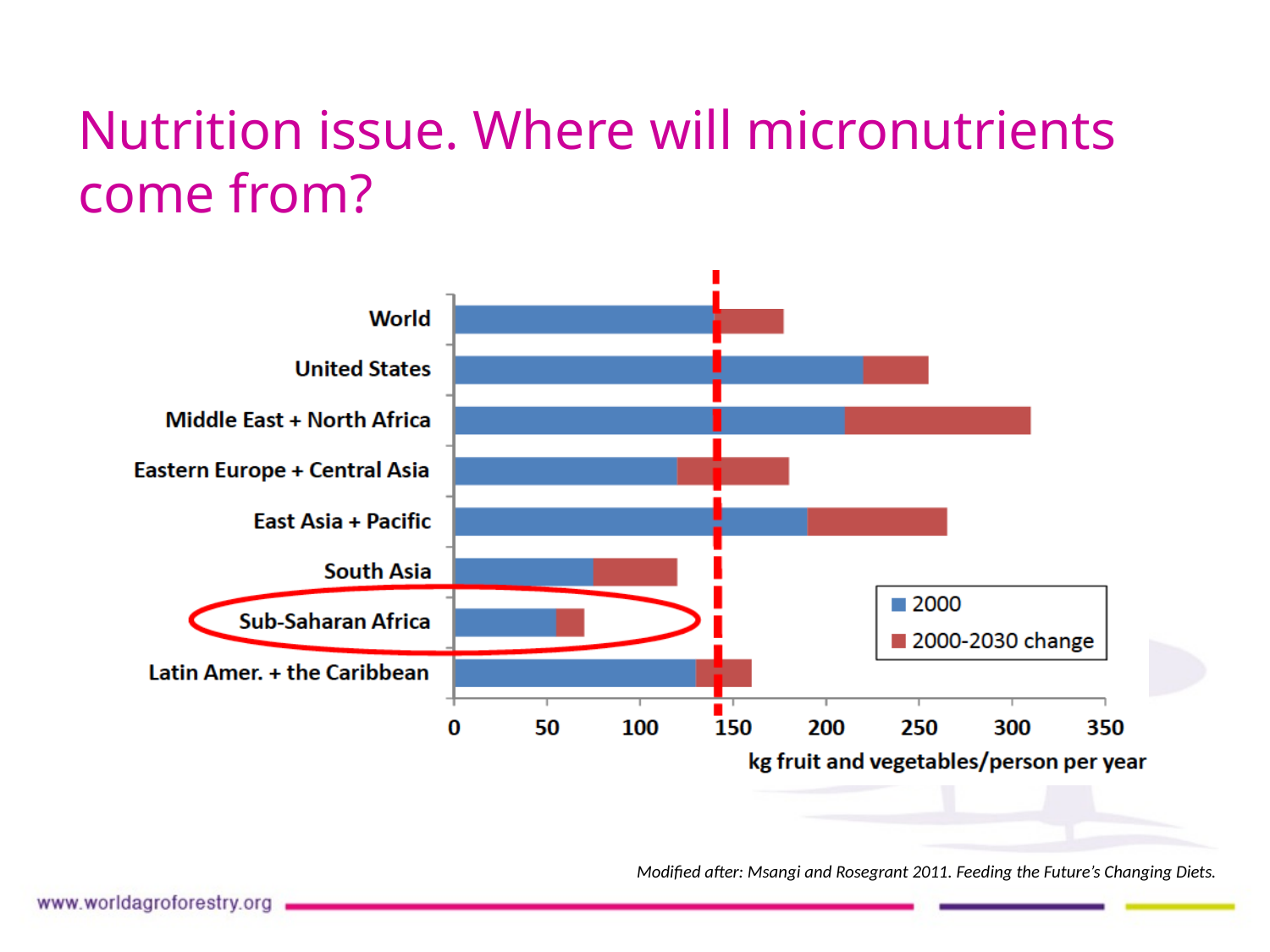
Is the 2000 value for the United States greater or less than 200? greater Which region has the highest 2000 value? United States What are the two series named in the legend? 2000 and 2000-2030 change What kind of chart is shown on the slide? Stacked bar chart What is the label of the horizontal axis? kg fruit and vegetables/person per year Which is larger, the 2000 value for the United States or the 2000 value for East Asia + Pacific? United States How many series does the chart legend list? 2 Which region has the longest total bar (2000 plus 2000-2030 change)? Middle East + North Africa Is the 2000 value for Sub-Saharan Africa greater or less than 100? less Is the 2000 value for South Asia greater or less than 100? less How many regions (categories) are plotted on the chart? 8 Which region has the shortest total bar? Sub-Saharan Africa